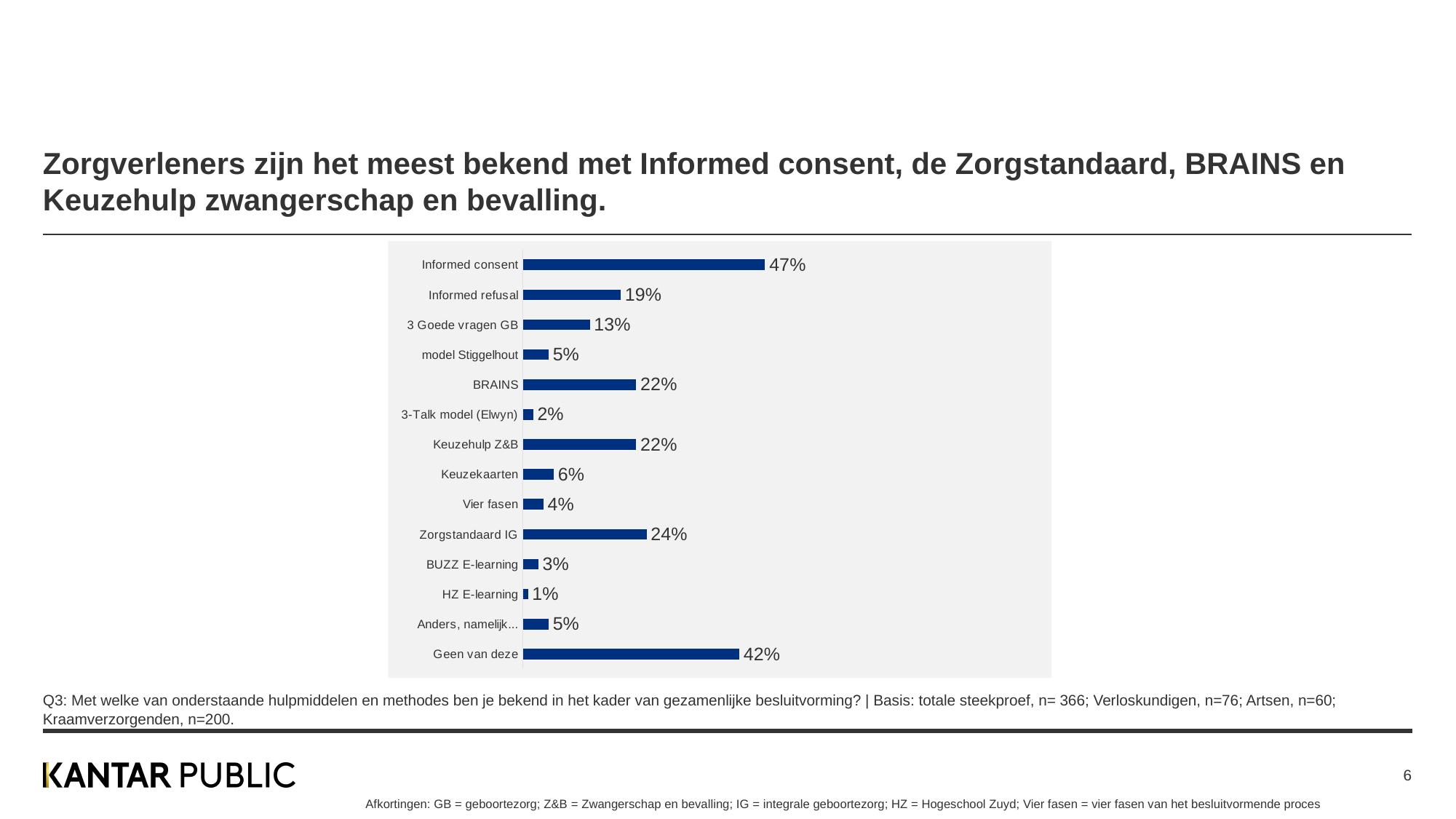
What is the difference between the values for Informed refusal and 3 Goede vragen GB? 6% Which is larger, the value for BRAINS or the value for Zorgstandaard IG? Zorgstandaard IG Which category has the lowest value? HZ E-learning What colour are the bars in the chart? Dark blue What kind of chart is shown on the slide? Bar chart What is the value for Informed consent? 47% How many categories are shown in the chart? 14 What is the difference between the values for Informed consent and Geen van deze? 5% What is the value for Zorgstandaard IG? 24% What is the value for Geen van deze? 42% What is the value for 3-Talk model (Elwyn)? 2% Which category has the highest value? Informed consent